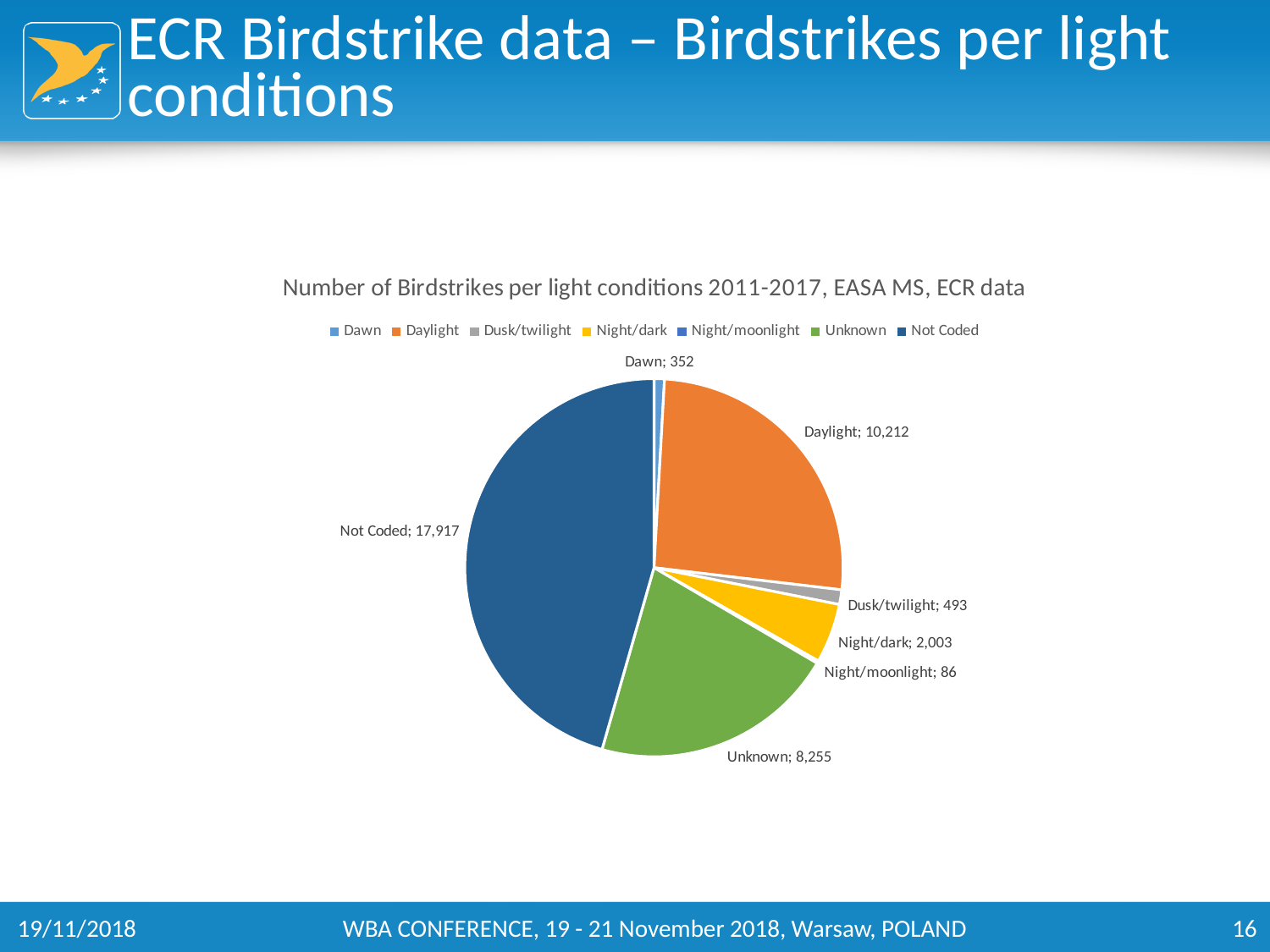
Which light condition has the smallest number of birdstrikes? Night/moonlight Which is larger, Daylight or Unknown? Daylight Which light condition has the largest number of birdstrikes? Not Coded How many birdstrikes are shown for Daylight? 10,212 How many light condition categories are shown in the pie chart? 7 What is the difference between the Night/dark and Dusk/twilight values? 1,510 How many birdstrikes are recorded for Night/moonlight? 86 What is the value for the Not Coded slice? 17,917 What type of chart is shown on the slide? Pie chart What is the title of the chart? Number of Birdstrikes per light conditions 2011-2017, EASA MS, ECR data What is the difference between the Not Coded and Daylight values? 7,705 What is the value for Dusk/twilight? 493